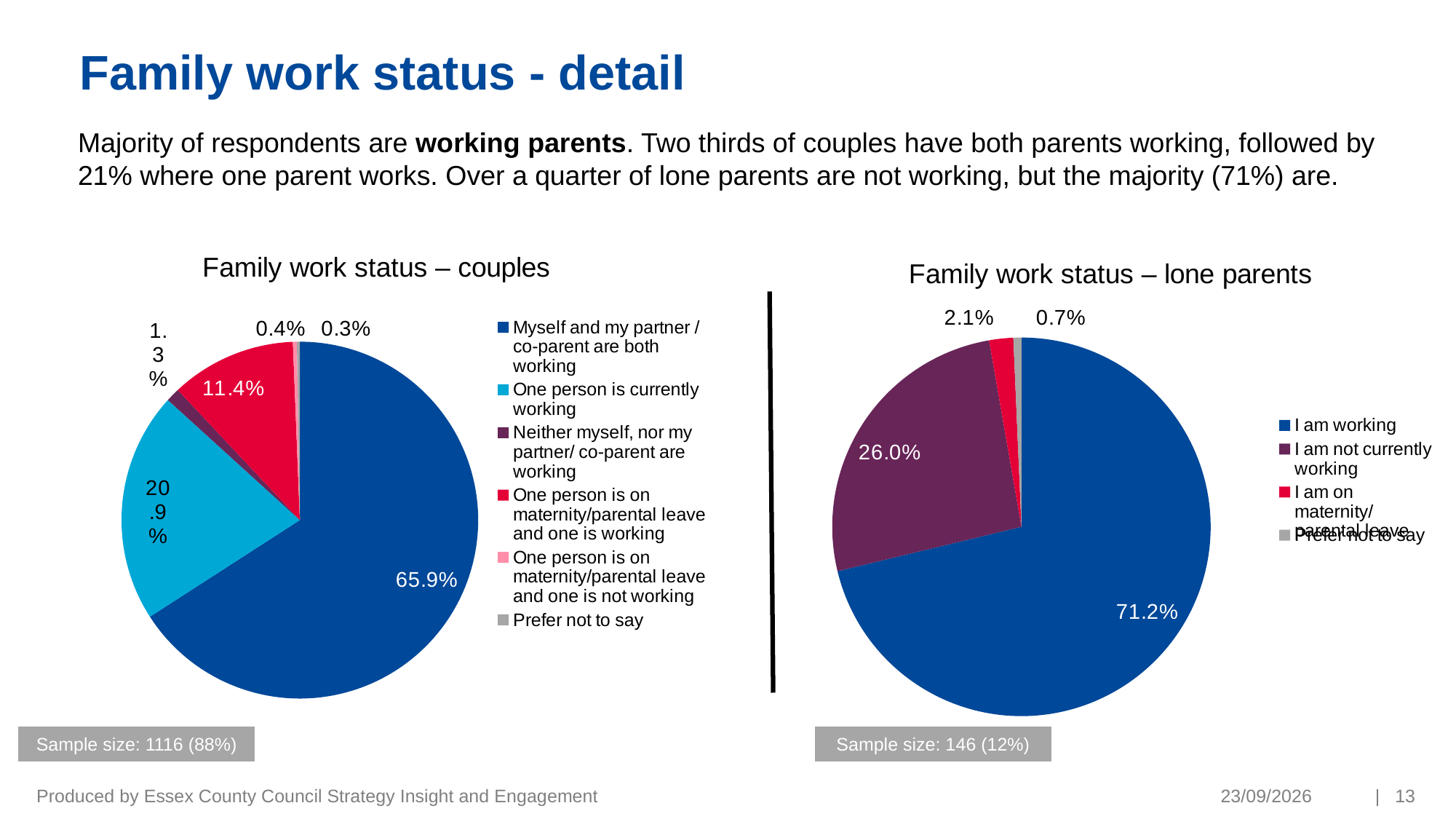
In the 'Family work status – lone parents' chart, what is the difference between 'I am working' and 'I am not currently working'? 45.2% In the 'Family work status – lone parents' chart, what percentage are 'I am not currently working'? 26.0% In the 'Family work status – couples' chart, what percentage is 'One person is on maternity/parental leave and one is working'? 11.4% In the 'Family work status – couples' chart, what percentage of couples have both parents working? 65.9% What type of chart is used for 'Family work status – couples'? Pie chart In the 'Family work status – couples' chart, which category has the largest share? Myself and my partner / co-parent are both working In the 'Family work status – couples' chart, what percentage is 'Neither myself, nor my partner/ co-parent are working'? 1.3% How many categories does the legend of the 'Family work status – couples' chart list? 6 In the 'Family work status – couples' chart, what share is 'One person is currently working'? 20.9% In the 'Family work status – lone parents' chart, which category has the smallest share? Prefer not to say Which is larger: 'One person is currently working' in the couples chart or 'I am not currently working' in the lone parents chart? I am not currently working (lone parents) In the 'Family work status – lone parents' chart, what percentage of lone parents are working? 71.2%